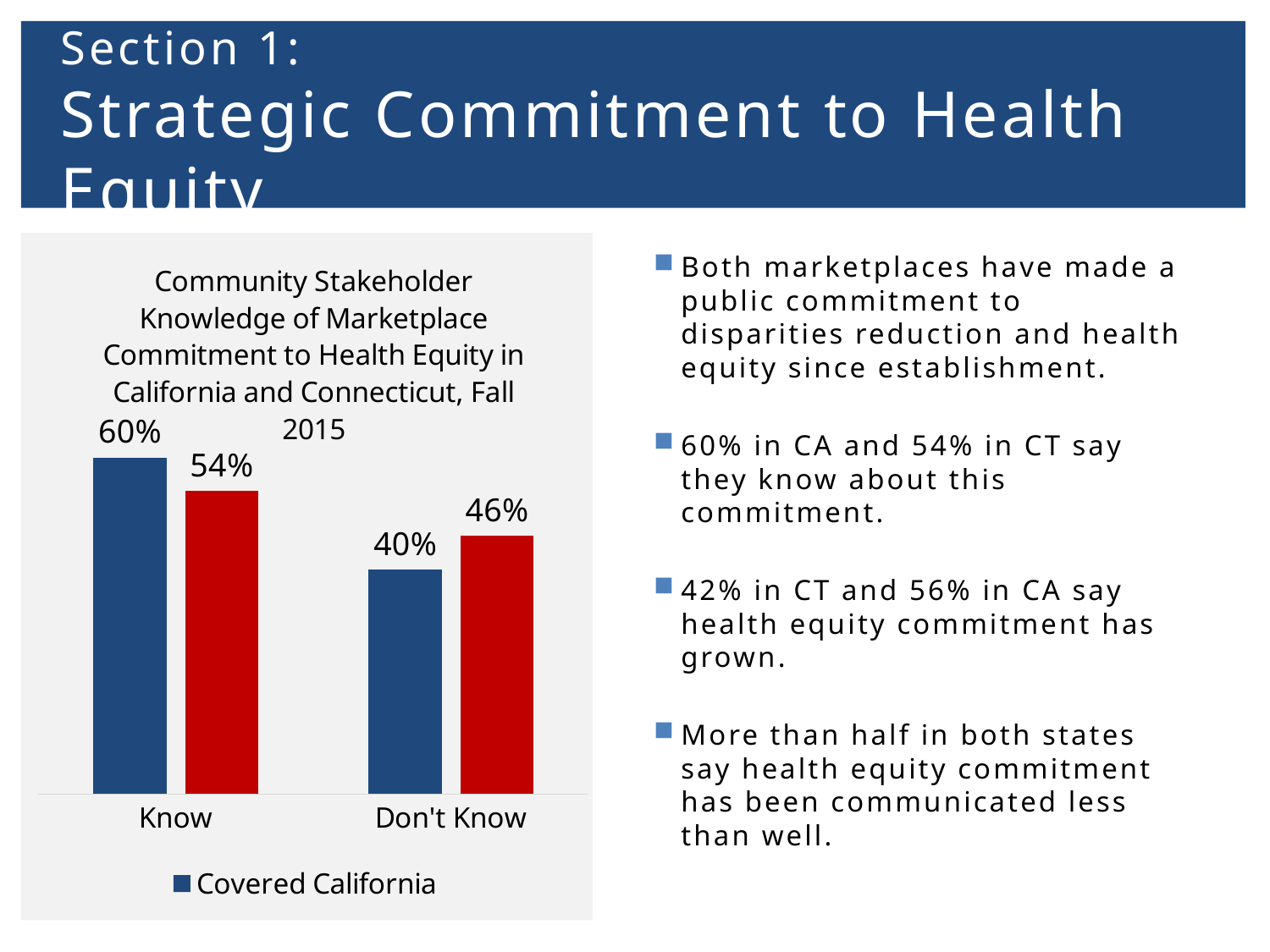
In the Know category, what is the difference between the Covered California bar and the red bar? 6% Which series is named in the chart legend? Covered California What is the value for Covered California in the Know category? 60% What kind of chart is shown on the slide? bar chart In the Don't Know category, which is larger: the Covered California bar or the red bar? the red bar How many categories are shown on the x axis? 2 What is the value for Covered California in the Don't Know category? 40% What value does the red bar show for the Don't Know category? 46% Which category has the higher value for Covered California? Know How many series does the legend list? 1 What is the difference between the Covered California values for Know and Don't Know? 20% What value does the red bar show for the Know category? 54%